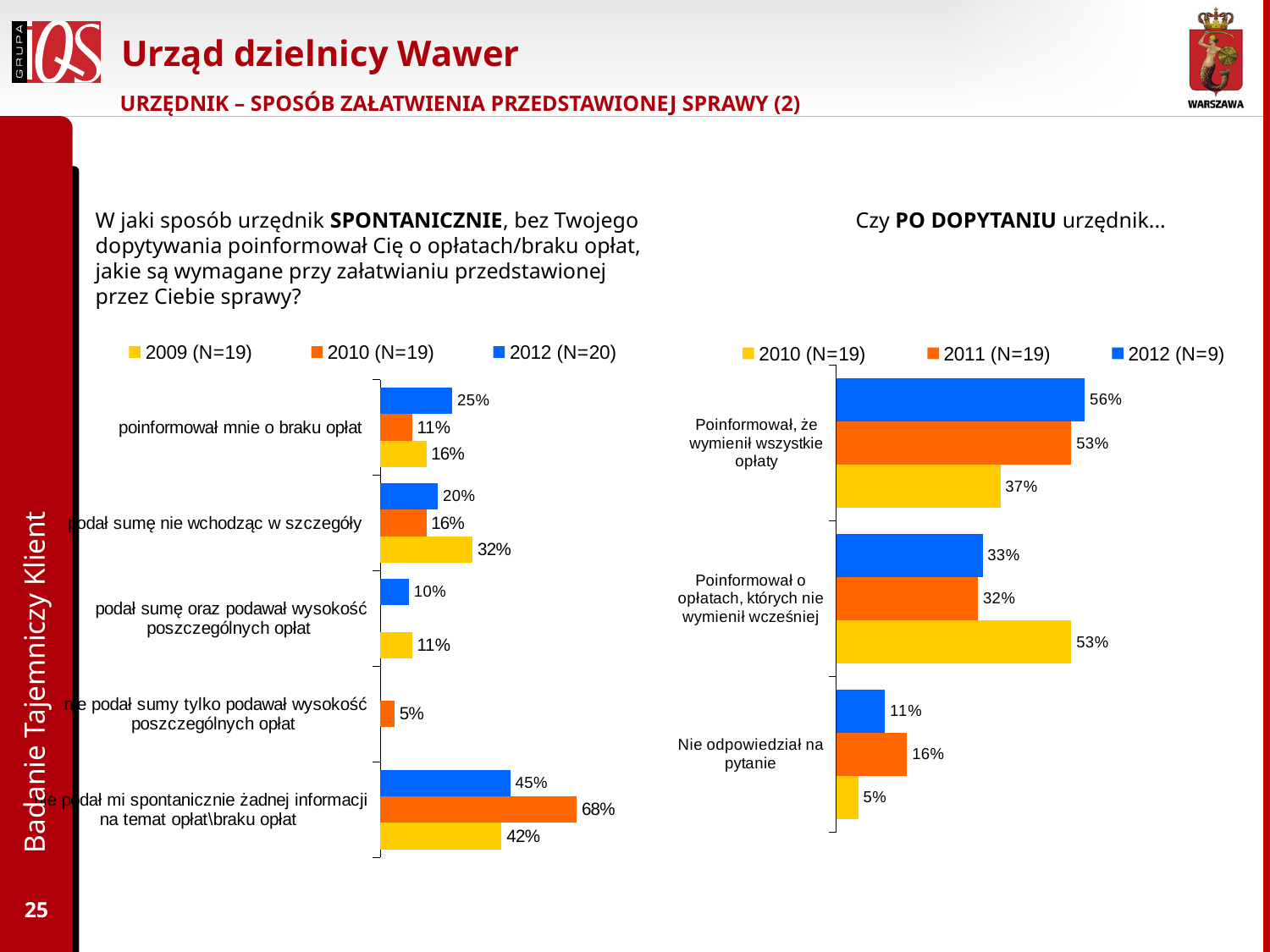
In the right chart (PO DOPYTANIU), what is the difference between the 2011 and 2012 values for 'Nie odpowiedział na pytanie'? 5 percentage points In the right chart (PO DOPYTANIU), what is the 2012 (N=9) value for 'Poinformował, że wymienił wszystkie opłaty'? 56% What type of chart is the right chart (PO DOPYTANIU)? Bar chart In the left chart (SPONTANICZNIE), what is the 2010 (N=19) value for 'nie podał mi spontanicznie żadnej informacji na temat opłat\braku opłat'? 68% In the left chart (SPONTANICZNIE), what is the difference between the 2010 and 2009 values for 'nie podał mi spontanicznie żadnej informacji na temat opłat\braku opłat'? 26 percentage points In the left chart (SPONTANICZNIE), how many series does the legend list? 3 In the left chart (SPONTANICZNIE), which series has the highest value for 'podał sumę nie wchodząc w szczegóły'? 2009 (N=19) In the left chart (SPONTANICZNIE), how many categories are shown? 5 In the left chart (SPONTANICZNIE), what is the 2012 (N=20) value for 'poinformował mnie o braku opłat'? 25% In the right chart (PO DOPYTANIU), which series has the lowest value for 'Nie odpowiedział na pytanie'? 2010 (N=19) In the right chart (PO DOPYTANIU), which is larger for 'Poinformował, że wymienił wszystkie opłaty': the 2011 value or the 2010 value? 2011 (53%) In the right chart (PO DOPYTANIU), what is the 2010 (N=19) value for 'Poinformował o opłatach, których nie wymienił wcześniej'? 53%